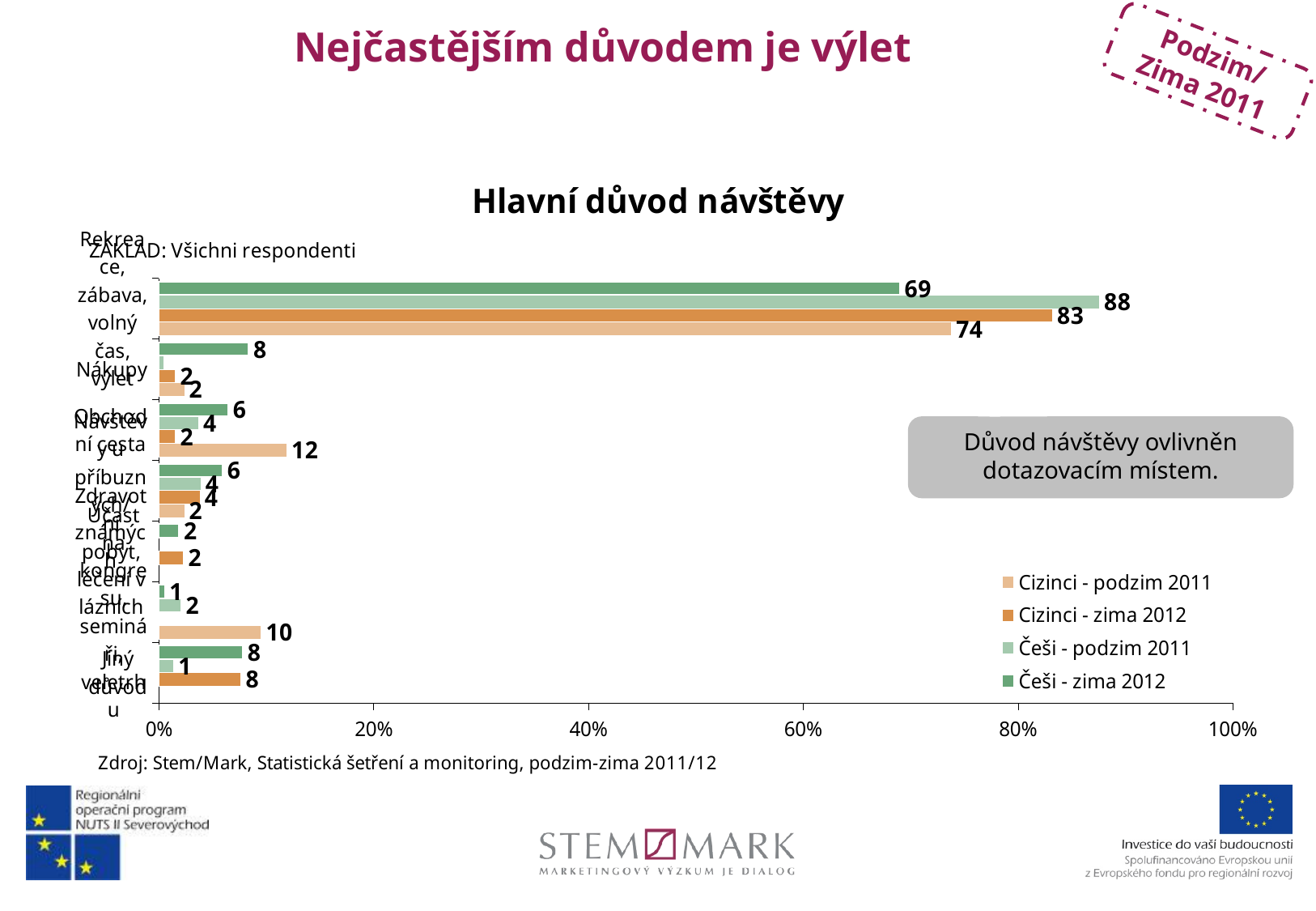
What is the value for Cizinci - zima 2012 in the category Rekreace, zábava, volný čas, výlet? 83 In the category Rekreace, zábava, volný čas, výlet, which is larger: Cizinci - zima 2012 or Cizinci - podzim 2011? Cizinci - zima 2012 What is the value for Češi - zima 2012 in the category Rekreace, zábava, volný čas, výlet? 69 Which series has the lowest value in the category Rekreace, zábava, volný čas, výlet? Češi - zima 2012 What is the difference between Češi - podzim 2011 and Češi - zima 2012 in the category Rekreace, zábava, volný čas, výlet? 19 Which series has the highest value in the category Rekreace, zábava, volný čas, výlet? Češi - podzim 2011 What is the maximum value shown on the x axis of the chart? 100% What kind of chart is shown on the slide? bar chart What is the value for Češi - podzim 2011 in the category Rekreace, zábava, volný čas, výlet? 88 What is the title of the chart? Hlavní důvod návštěvy How many series does the legend of the chart list? 4 What is the value for Cizinci - podzim 2011 in the category Rekreace, zábava, volný čas, výlet? 74